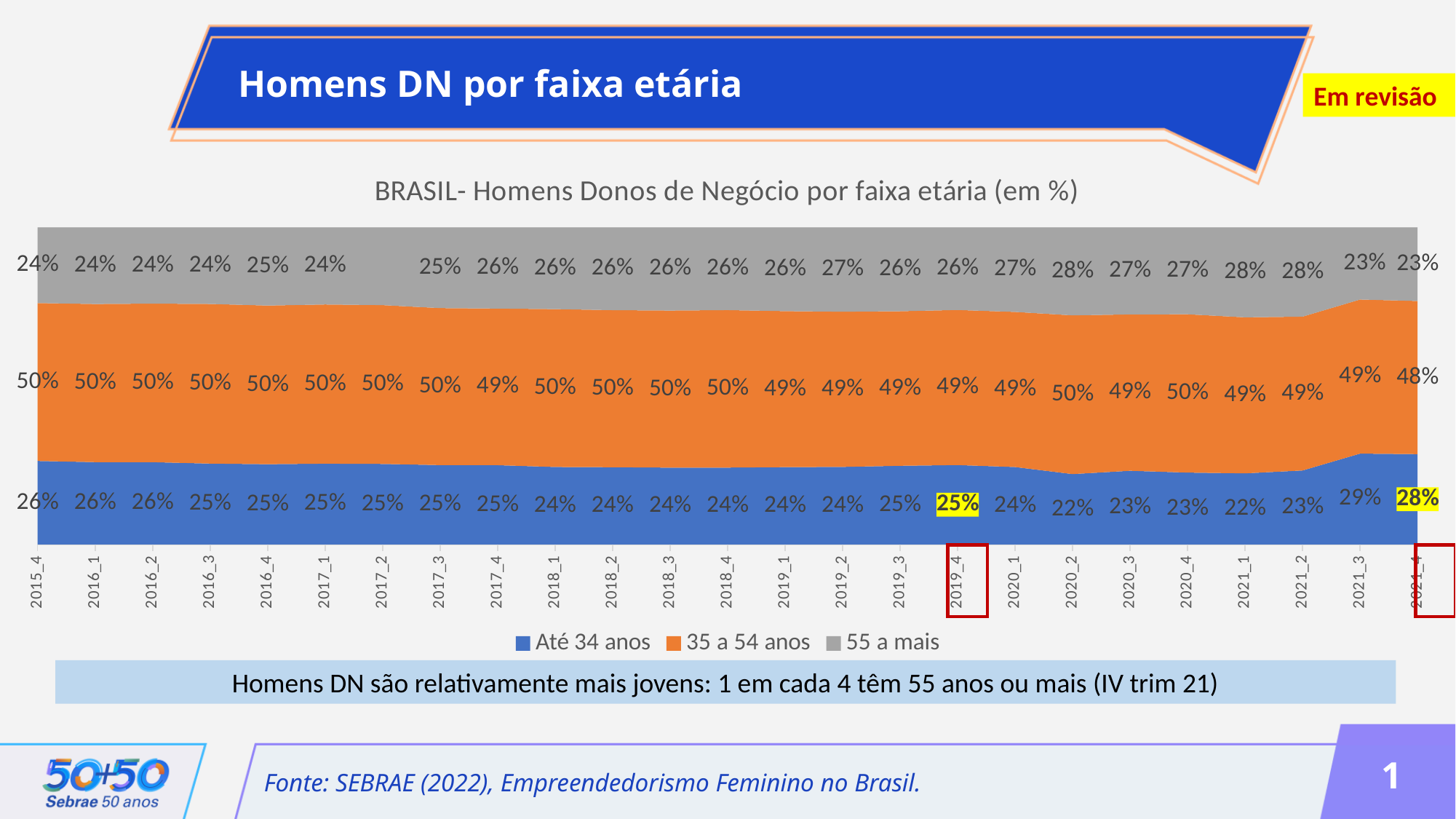
What is the value for '35 a 54 anos' in 2021_4? 48% In which quarter is the 'Até 34 anos' share highest? 2021_3 What is the total of the three series in 2015_4? 100% What is the value for '55 a mais' in 2020_2? 28% What is the difference between the 'Até 34 anos' value in 2021_3 and in 2020_2? 7 percentage points Which is larger for '55 a mais': the value in 2020_2 or in 2021_4? 2020_2 What kind of chart is shown on the slide? Stacked area chart How many quarters (x-axis categories) are plotted in the chart? 25 In which quarter is the '35 a 54 anos' share lowest? 2021_4 What is the value for 'Até 34 anos' in 2021_4? 28% What is the title of the chart? BRASIL- Homens Donos de Negócio por faixa etária (em %) How many series does the legend list? 3